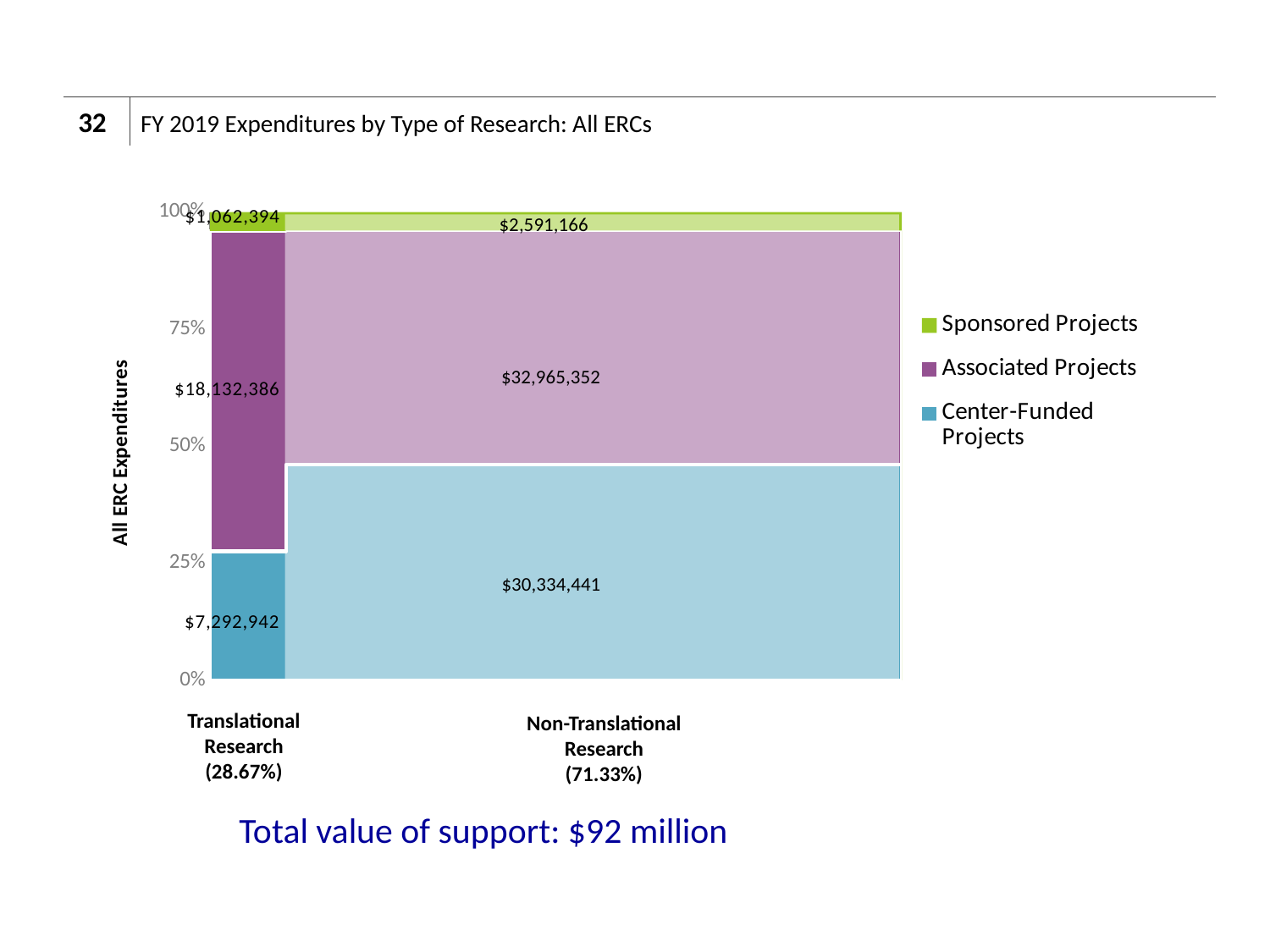
Which series has the highest value for Non-Translational Research? Associated Projects What is the total of the stacked bar for Translational Research? $26,487,722 What is the value of Center-Funded Projects for Translational Research? $7,292,942 What is the value of Associated Projects for Non-Translational Research? $32,965,352 What is the difference between the Center-Funded Projects values for Non-Translational Research and Translational Research? $23,041,499 Which series has the lowest value for Translational Research? Sponsored Projects How many series does the legend list? 3 What is the value of Sponsored Projects for Non-Translational Research? $2,591,166 What is the value of Associated Projects for Translational Research? $18,132,386 Which is larger: Sponsored Projects for Translational Research or Sponsored Projects for Non-Translational Research? Non-Translational Research How many research categories are shown on the x axis? 2 What percentage share is shown for Non-Translational Research on the x-axis label? 71.33%